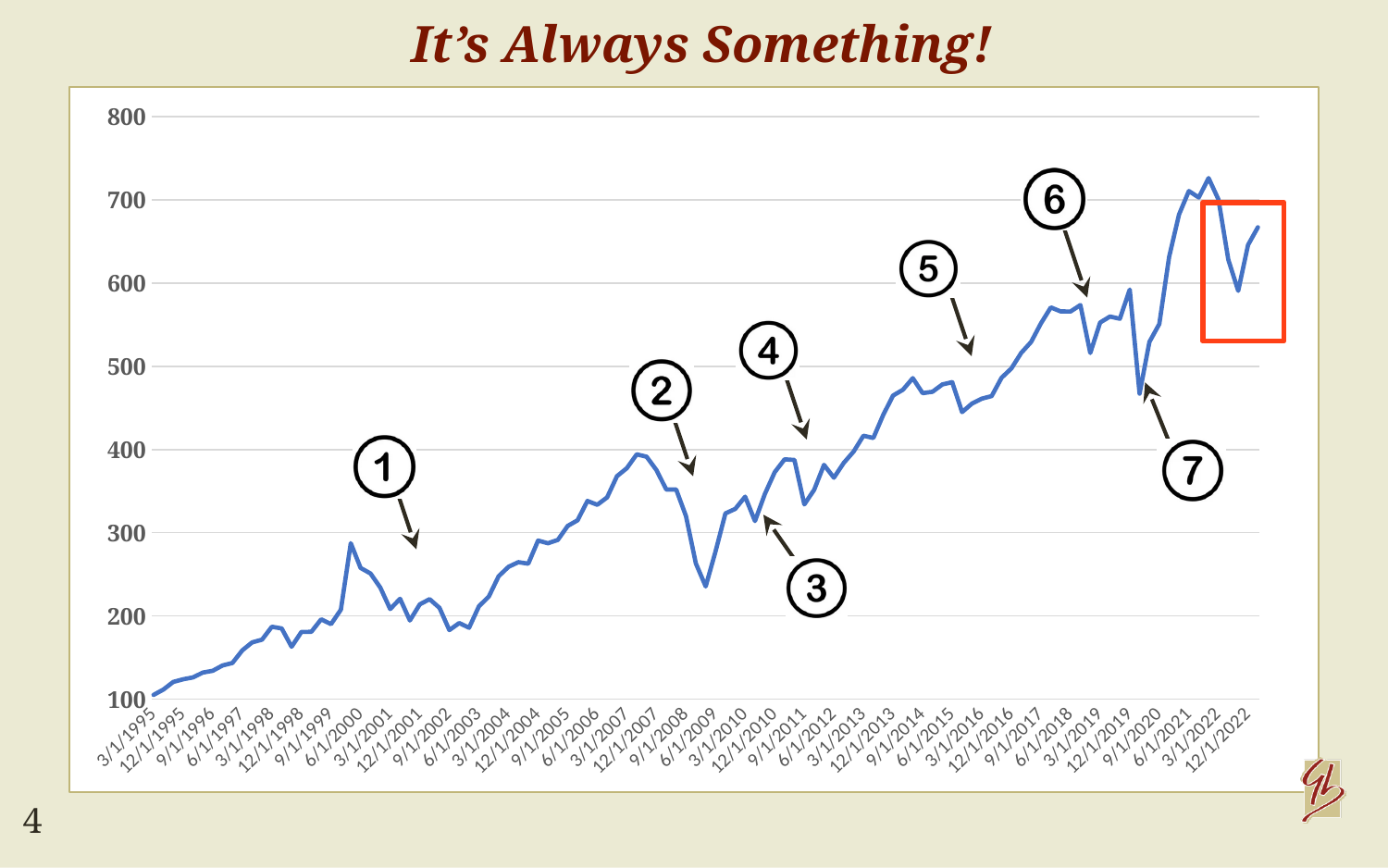
Is the value at 6/1/2021 greater or less than 600? greater Is the value at 6/1/2009 greater or less than 300? less Which is larger, the value at 3/1/1995 or the value at 12/1/2022? 12/1/2022 What is the title of the chart on the slide? It's Always Something! Is the value at 3/1/1995 greater or less than 200? less How many numbered circle markers are placed on the chart? 7 Overall, does the line rise or fall from 3/1/1995 to 12/1/2022? rise What kind of chart is shown on the slide? line chart Which is larger, the value at 6/1/2009 or the value at 6/1/2021? 6/1/2021